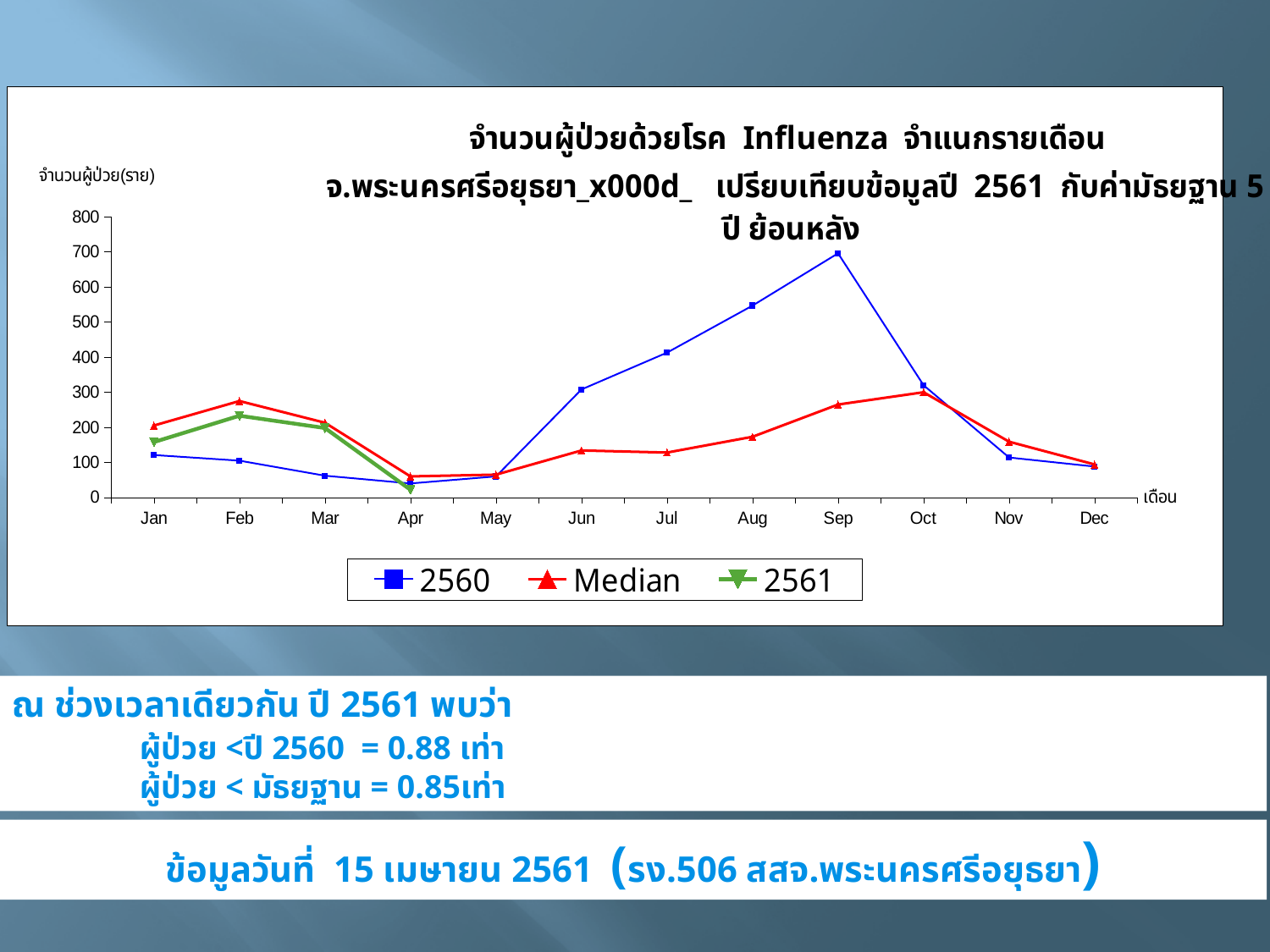
What kind of chart is shown on the slide? line chart What colour is the Median series line? red Is the value for 2560 in Sep greater or less than 600? greater In Jan, which is larger: the 2560 value or the Median value? Median In which month does the 2560 series reach its highest value? Sep How many series does the legend list? 3 Is the value for 2561 in Apr greater or less than 100? less How many months are shown on the x axis? 12 In which month does the 2561 series reach its lowest value? Apr Is the value for Median in Feb greater or less than 200? greater Does the 2560 series rise or fall from May to Sep? rise In which month does the Median series reach its highest value? Oct